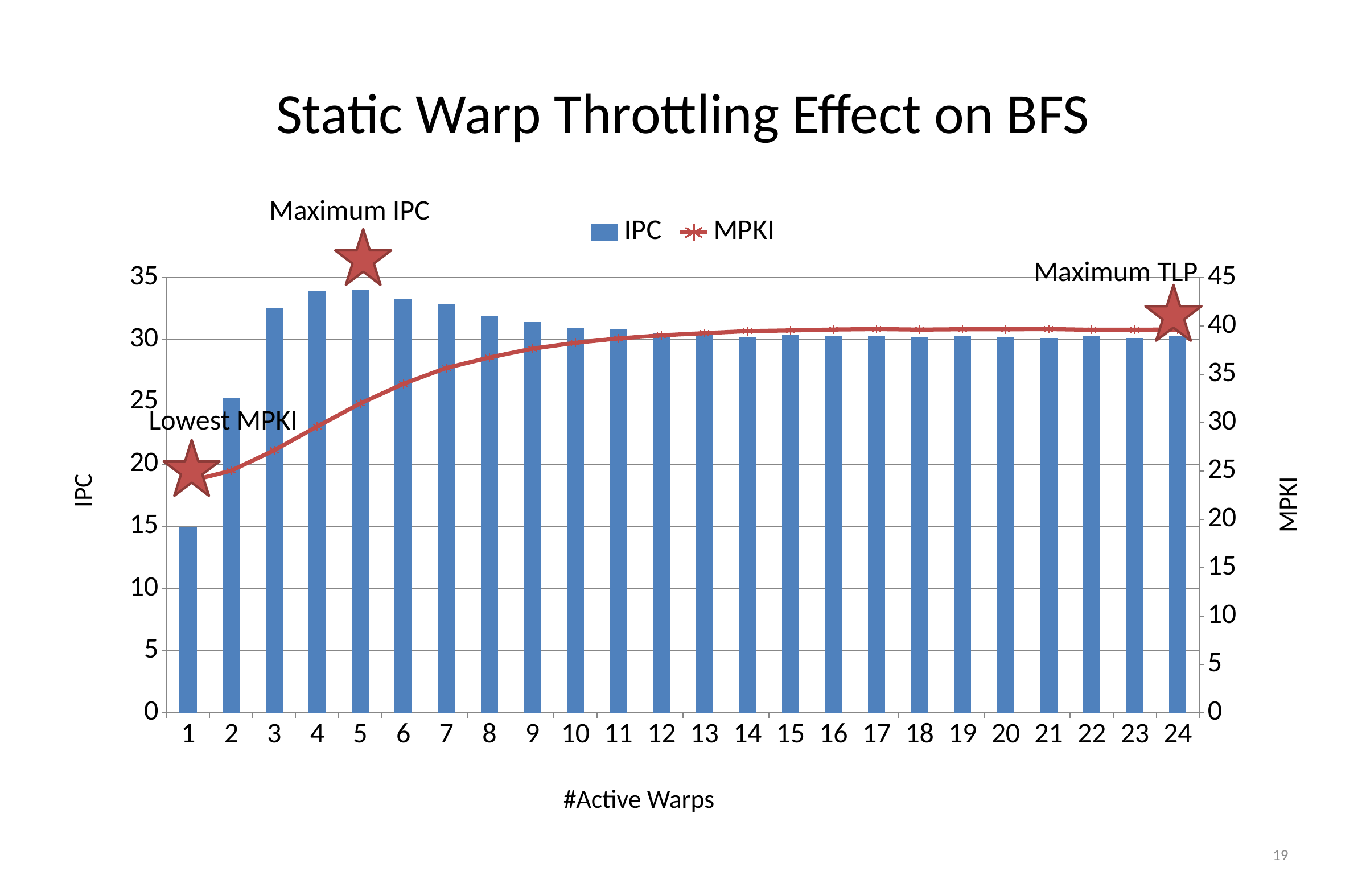
Is the IPC value for 1 active warp greater or less than 20? less What is the label of the x axis? #Active Warps Is the MPKI value for 24 active warps greater or less than 35? greater How many series does the legend list? 2 Does MPKI generally rise or fall as the number of active warps increases? rise At which number of active warps is MPKI lowest? 1 At which number of active warps is IPC at its maximum, according to the annotation? 5 What kind of chart is shown on the slide? A combined bar and line chart Which has the higher IPC: 2 active warps or 3 active warps? 3 active warps Is the IPC value for 3 active warps greater or less than 30? greater How many active-warp categories are plotted along the x axis? 24 At which number of active warps is IPC lowest? 1